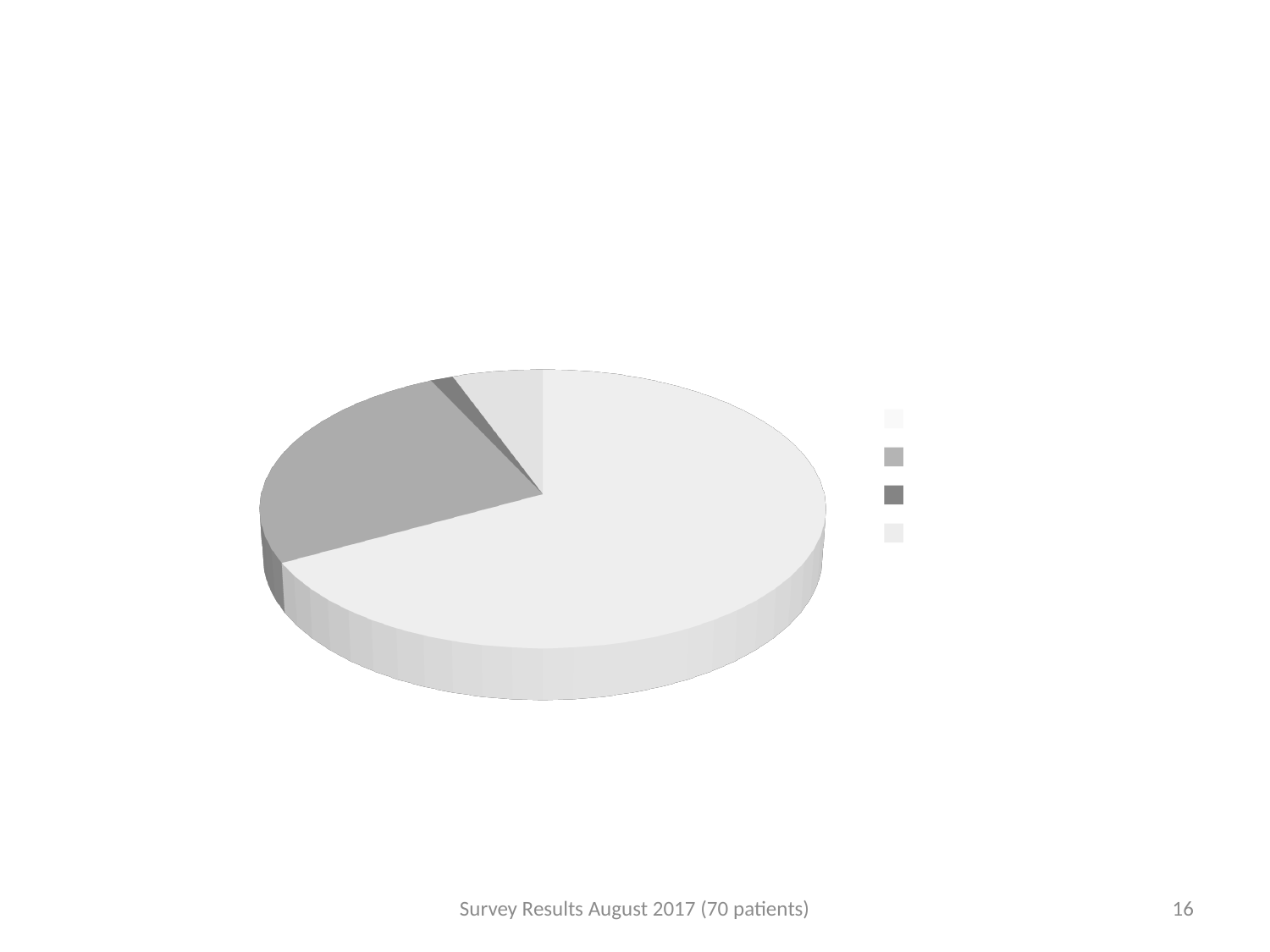
Is the largest slice of the pie chart more or less than half of the pie? more What kind of chart is shown on the slide? pie chart How many slices does the pie chart have? 4 Does the pie chart on the slide have a title? No How many entries does the legend of the pie chart list? 4